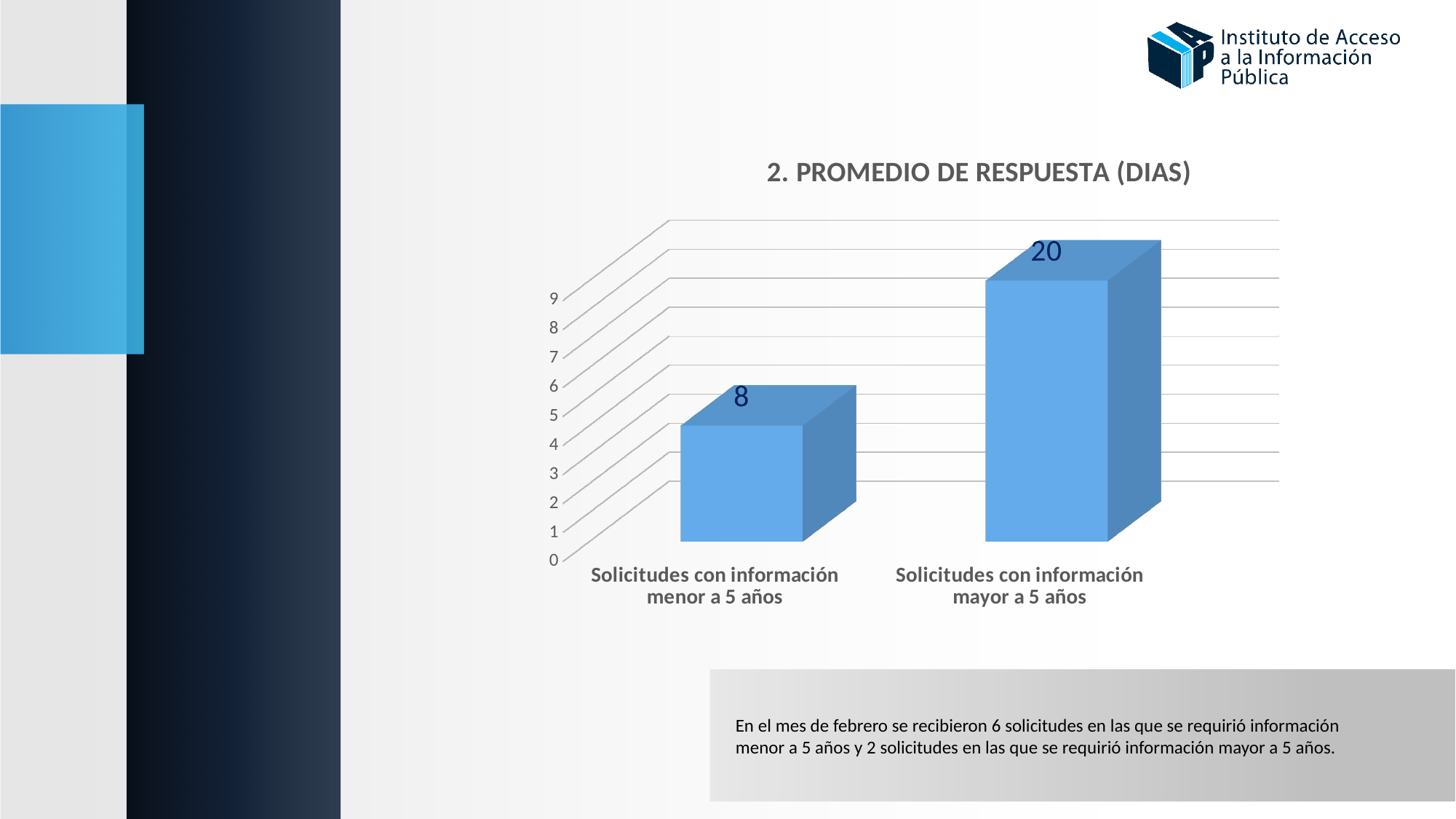
Which category has the highest value? Solicitudes con información mayor a 5 años What is the total of the two values shown in the chart? 28 What kind of chart is shown on the slide? Bar chart What is the value for "Solicitudes con información menor a 5 años"? 8 What is the difference between the value for "Solicitudes con información mayor a 5 años" and the value for "Solicitudes con información menor a 5 años"? 12 Which is larger: the value for "Solicitudes con información menor a 5 años" or the value for "Solicitudes con información mayor a 5 años"? Solicitudes con información mayor a 5 años What is the value for "Solicitudes con información mayor a 5 años"? 20 How many categories are shown in the chart? 2 Which category has the lowest value? Solicitudes con información menor a 5 años What colour are the bars in the chart? Blue Do the values rise or fall from the left category to the right category? Rise What is the title of the chart? 2. PROMEDIO DE RESPUESTA (DIAS)